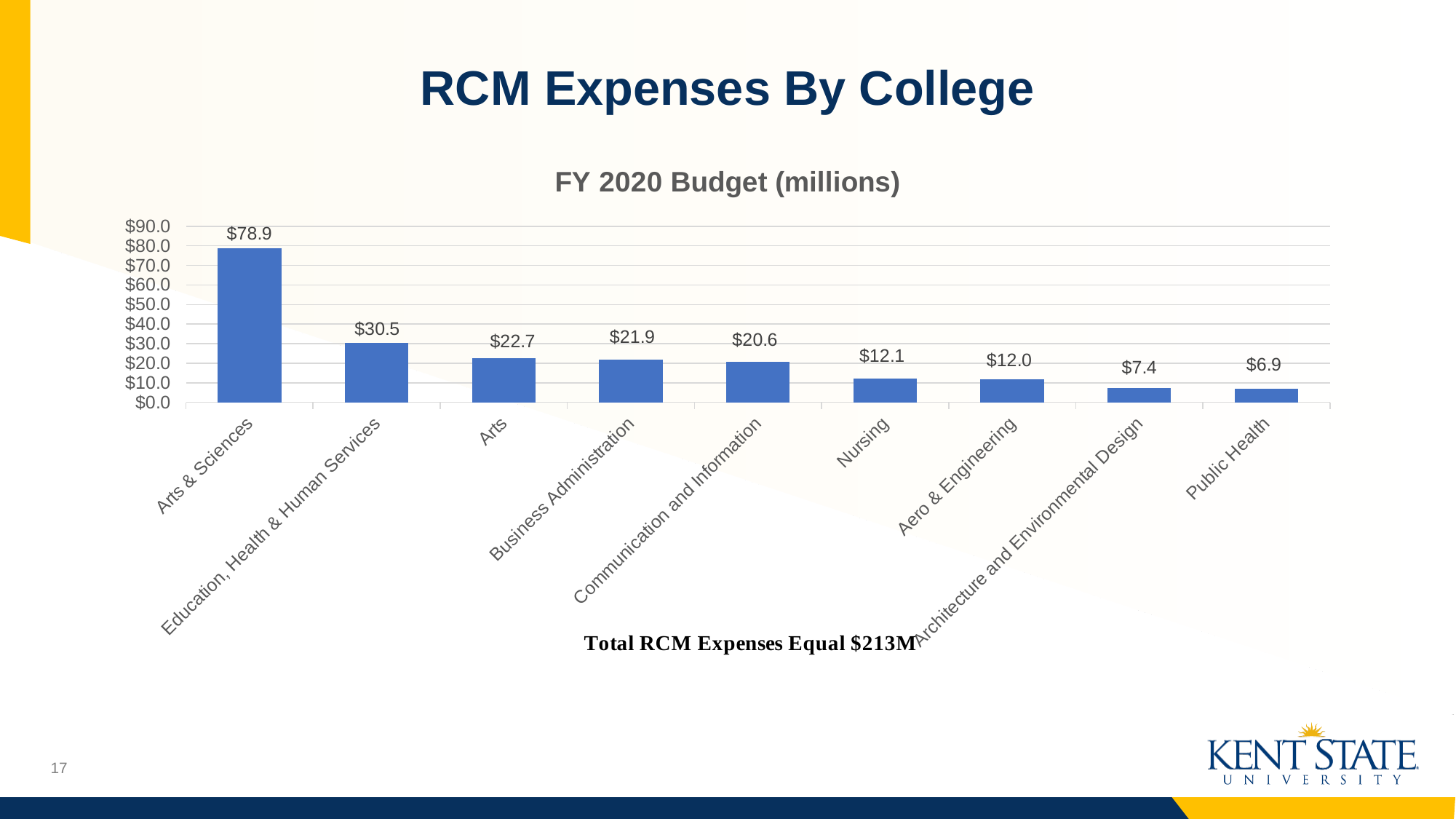
Which has a larger FY 2020 budget, Business Administration or Communication and Information? Business Administration Which college has the highest FY 2020 budget? Arts & Sciences What is the FY 2020 budget value for Nursing? $12.1 What is the FY 2020 budget value for Architecture and Environmental Design? $7.4 What is the title of the chart? FY 2020 Budget (millions) What kind of chart is shown on the slide? bar chart How many colleges are shown on the chart? 9 What is the FY 2020 budget value for Arts & Sciences? $78.9 Do the values rise or fall from left to right along the x axis? fall What is the difference between the budget for Education, Health & Human Services and the budget for Arts? $7.8 Which college has the lowest FY 2020 budget? Public Health Is the value for Aero & Engineering greater or less than $20.0? less